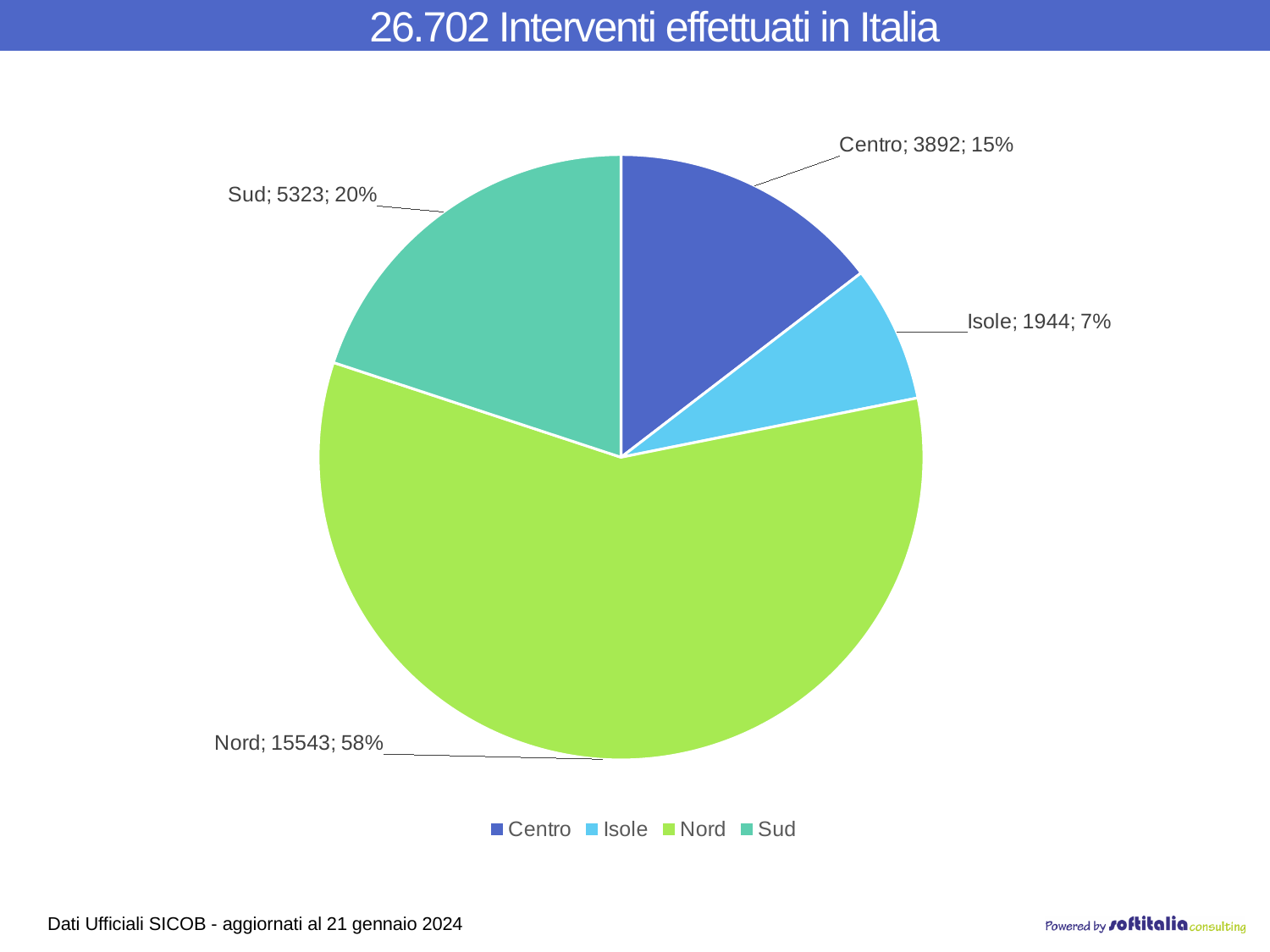
What type of chart is shown on the slide? pie chart Which region has the largest slice of the pie? Nord What is the title of the chart? 26.702 Interventi effettuati in Italia What is the difference between the number of interventions in Sud and in Centro? 1431 Which region has the smallest slice of the pie? Isole What percentage share does Centro have in the pie chart? 15% Which has more interventions, Centro or Isole? Centro What percentage share does Sud have in the pie chart? 20% Which colour represents Nord in the pie chart? green How many interventions were carried out in Isole? 1944 How many categories are shown in the pie chart? 4 How many interventions were carried out in Nord? 15543